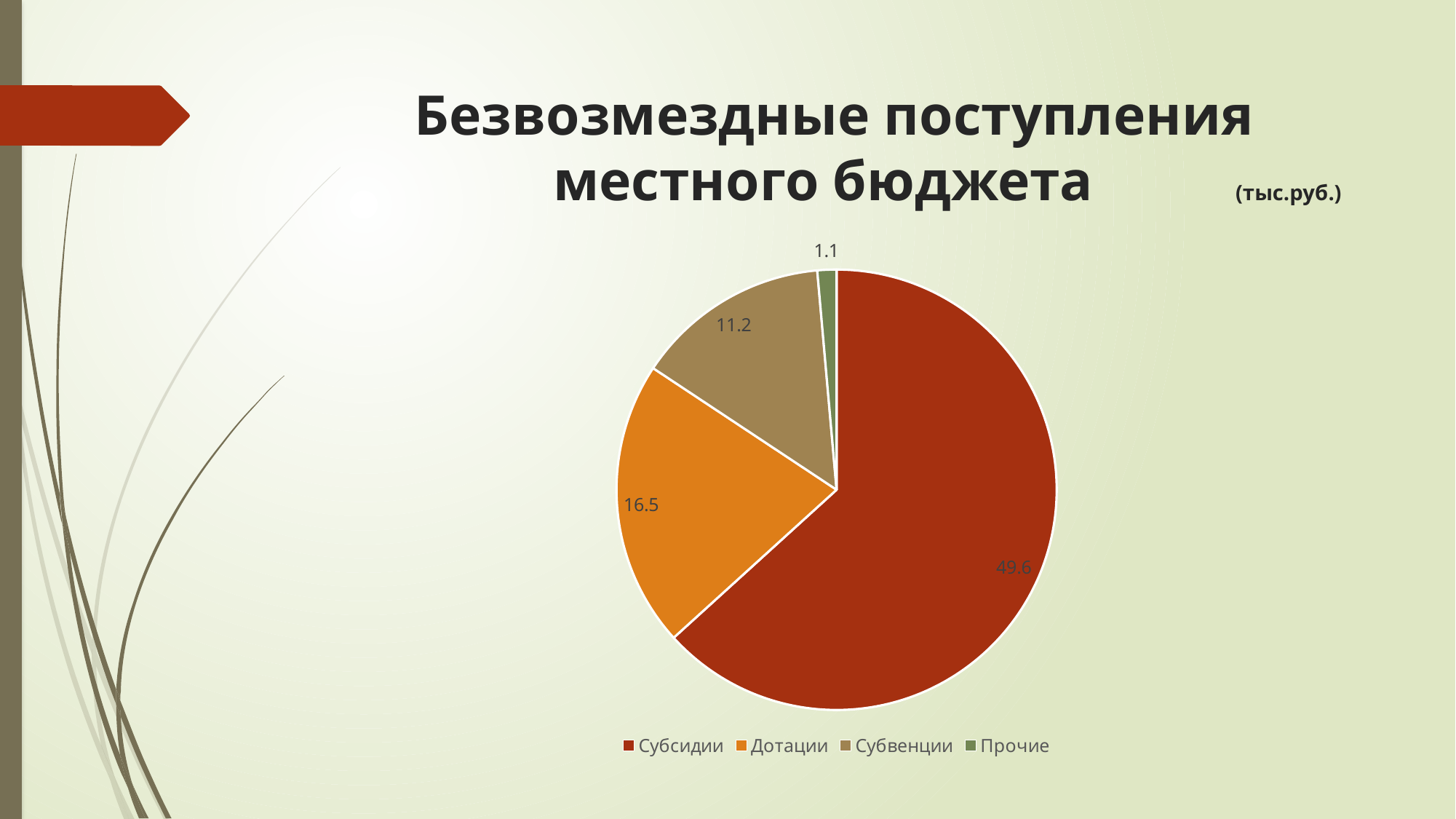
What is the value for Дотации? 16.5 Which category has the largest slice of the pie? Субсидии What kind of chart is shown on the slide? Pie chart Which is larger, the value for Субвенции or the value for Дотации? Дотации What is the difference between the values for Дотации and Субвенции? 5.3 How many categories does the pie chart show? 4 What is the value for Субвенции? 11.2 Which category has the smallest slice of the pie? Прочие What unit is given next to the chart title? тыс.руб. What is the value for Субсидии? 49.6 What is the value for Прочие? 1.1 What is the difference between the values for Субсидии and Дотации? 33.1